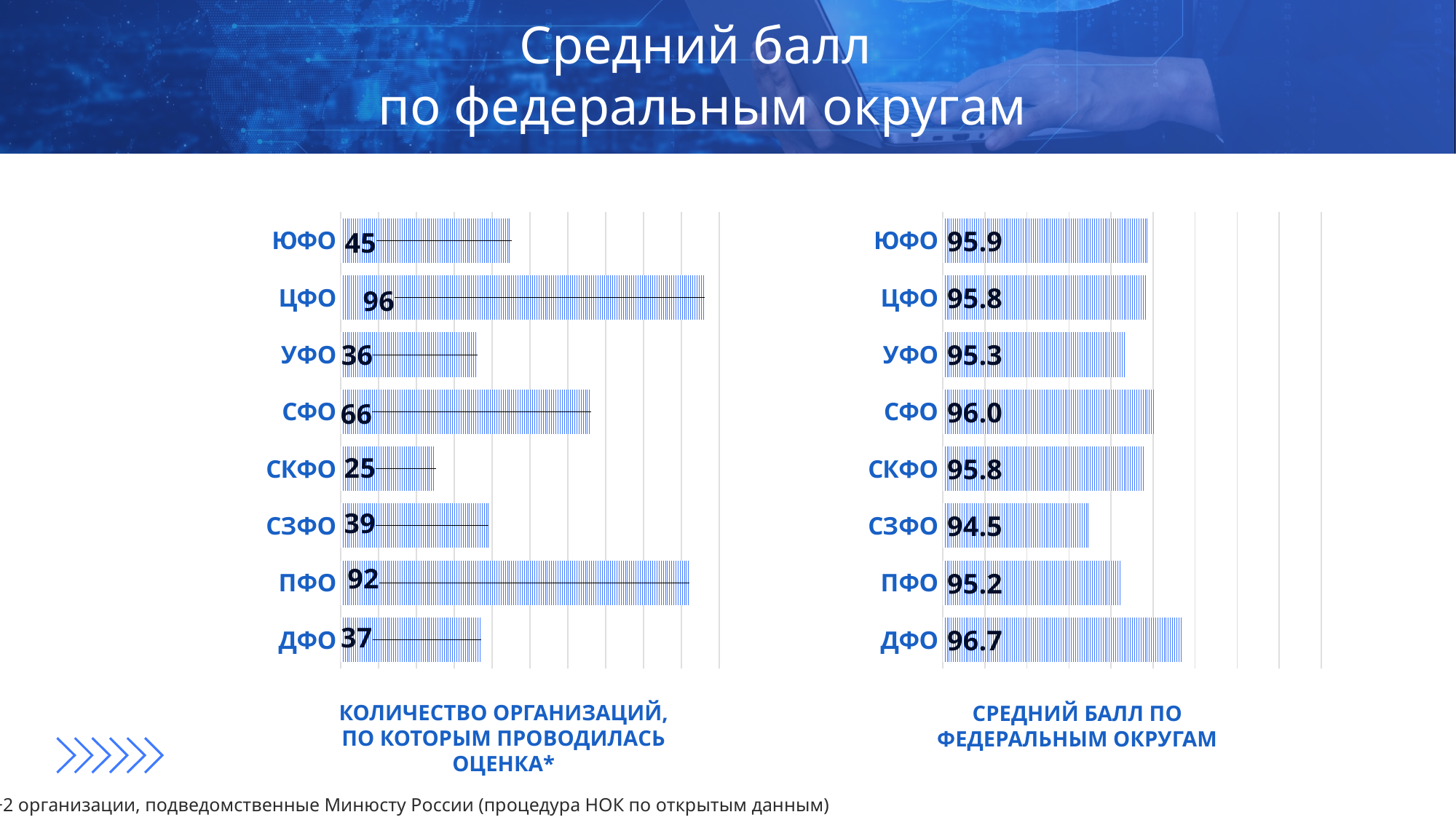
In the left chart (Количество организаций, по которым проводилась оценка), what is the value for ЦФО? 96 In the left chart (Количество организаций, по которым проводилась оценка), what is the value for СКФО? 25 What type of chart is the right chart (Средний балл по федеральным округам)? Bar chart How many federal districts are shown in the left chart (Количество организаций, по которым проводилась оценка)? 8 In the right chart (Средний балл по федеральным округам), which federal district has the highest average score? ДФО In the right chart (Средний балл по федеральным округам), which federal district has the lowest average score? СЗФО In the left chart (Количество организаций, по которым проводилась оценка), which federal district has the lowest value? СКФО In the left chart (Количество организаций, по которым проводилась оценка), what is the difference between the values for ЦФО and ПФО? 4 In the left chart (Количество организаций, по которым проводилась оценка), which federal district has the highest value? ЦФО In the right chart (Средний балл по федеральным округам), what is the value for СЗФО? 94.5 In the right chart (Средний балл по федеральным округам), what is the value for ДФО? 96.7 In the right chart (Средний балл по федеральным округам), which is larger, the value for ЮФО or the value for УФО? ЮФО